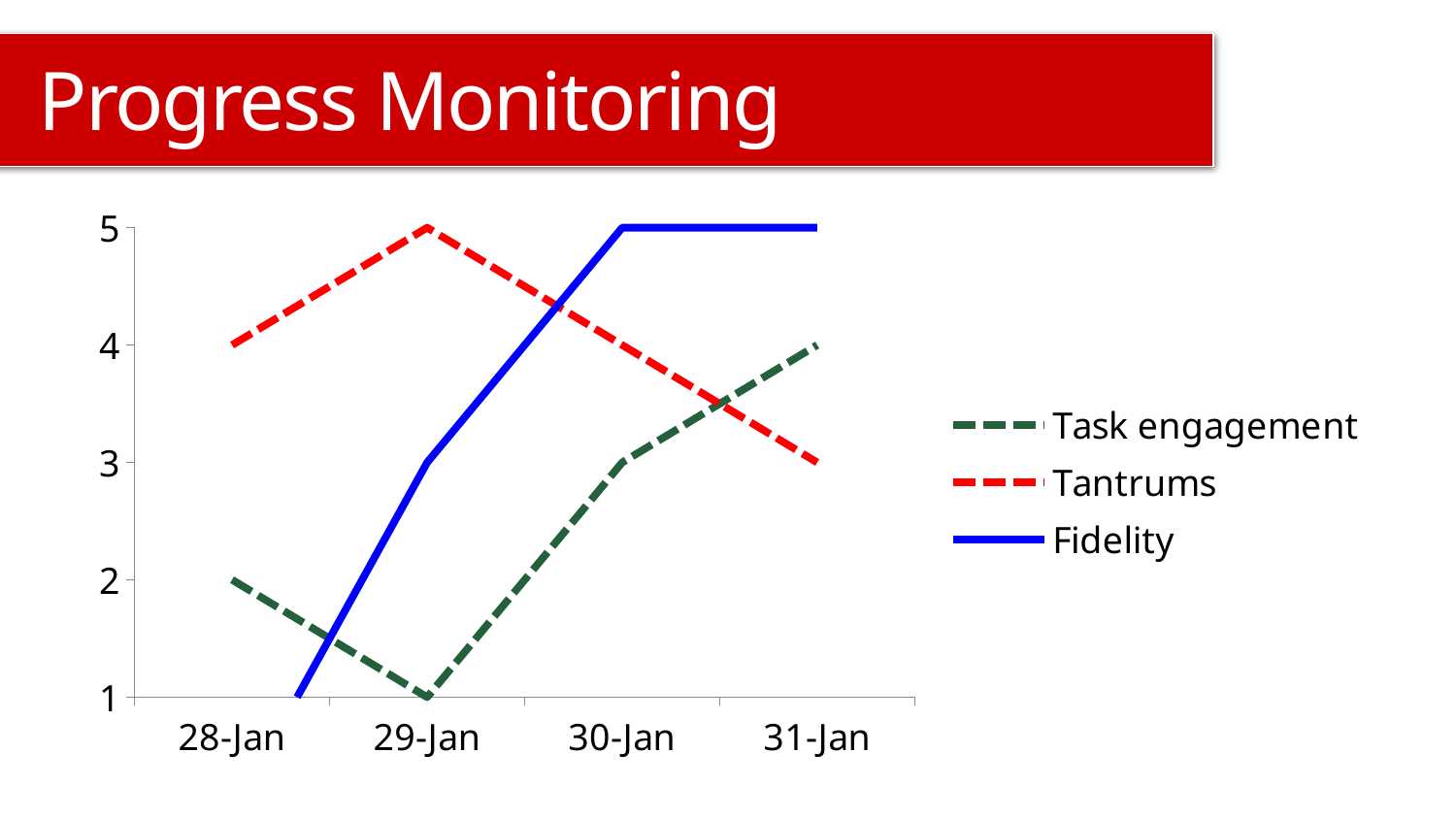
What kind of chart is shown on the slide? Line chart Which is larger on 28-Jan, Tantrums or Task engagement? Tantrums How many dates are shown on the x axis? 4 On which date is Task engagement lowest? 29-Jan On which date is Tantrums highest? 29-Jan How many series does the legend list? 3 What is the difference between Fidelity and Task engagement on 30-Jan? 2 What is the value of Tantrums on 29-Jan? 5 Does the Tantrums line rise or fall from 29-Jan to 31-Jan? Fall What is the value of Task engagement on 31-Jan? 4 Which series is drawn as a solid blue line? Fidelity